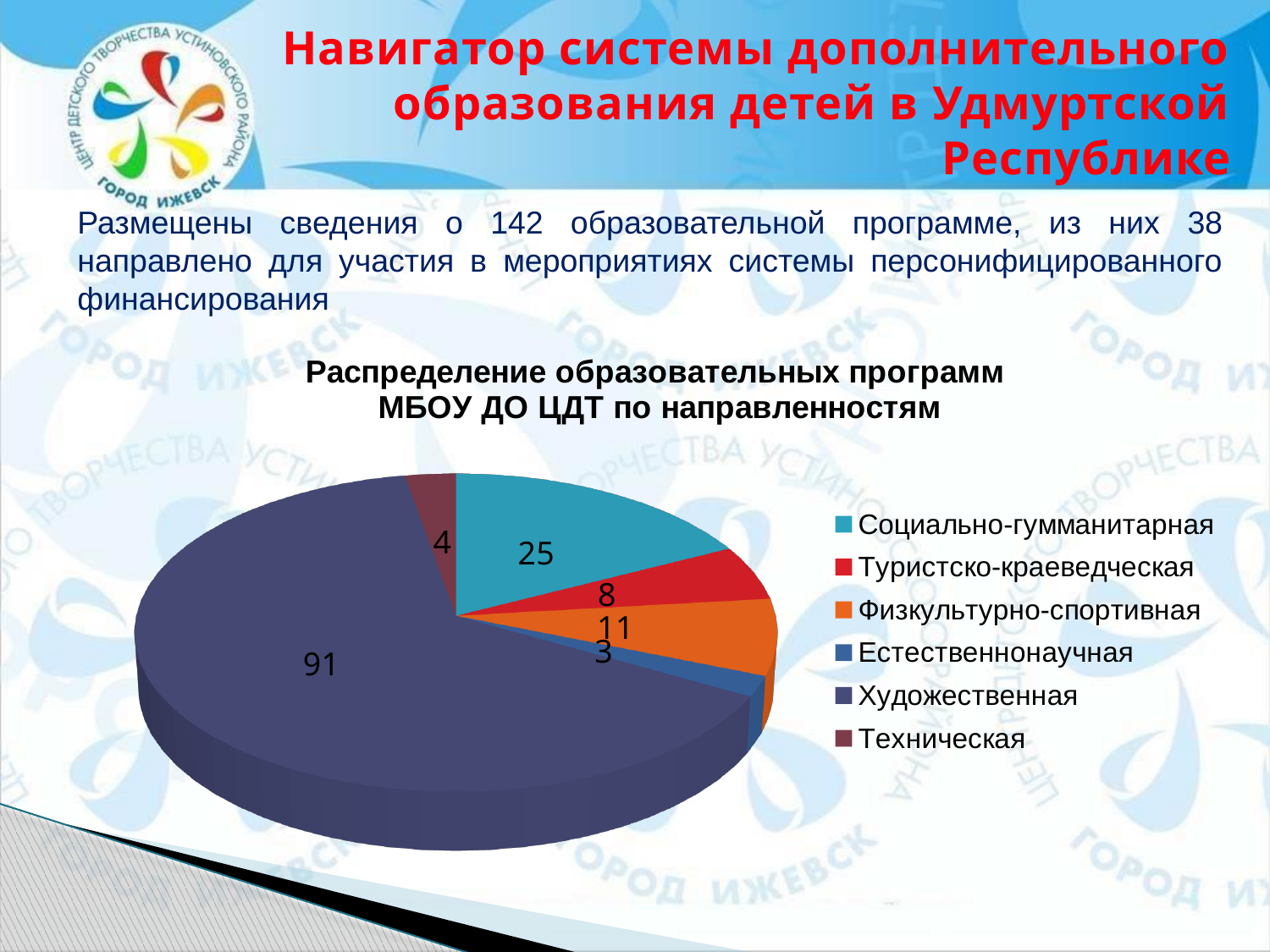
Which category has the smallest slice in the pie chart? Естественнонаучная How many categories does the pie chart show? 6 Which is larger, the value for Туристско-краеведческая or the value for Техническая? Туристско-краеведческая What is the value for Естественнонаучная in the pie chart? 3 What is the difference between the values for Художественная and Социально-гумманитарная? 66 What is the title of the pie chart? Распределение образовательных программ МБОУ ДО ЦДТ по направленностям What is the value for Физкультурно-спортивная in the pie chart? 11 What is the value for Художественная in the pie chart? 91 What is the total of all slices in the pie chart? 142 Which category has the largest slice in the pie chart? Художественная What is the value for Социально-гумманитарная in the pie chart? 25 What kind of chart is shown on the slide? pie chart